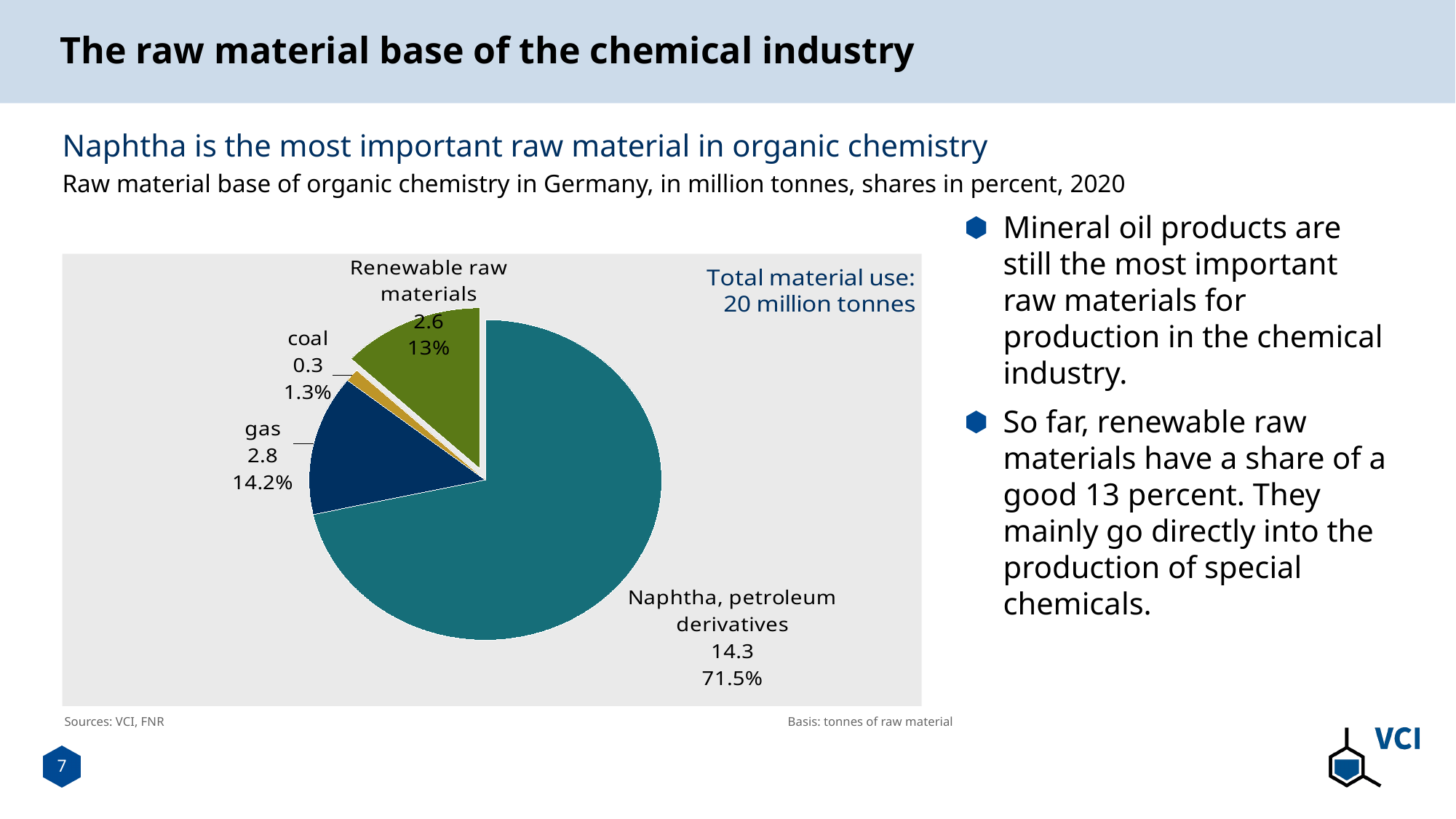
What is the share of Naphtha, petroleum derivatives? 71.5% What is the value in million tonnes for coal? 0.3 Which category has the largest slice? Naphtha, petroleum derivatives Which category has the smallest slice? coal What share of the pie does gas have? 14.2% What kind of chart is shown on the slide? pie chart What is the difference in million tonnes between gas and renewable raw materials? 0.2 What total material use is stated on the chart? 20 million tonnes What is the value in million tonnes for Naphtha, petroleum derivatives? 14.3 How many slices does the pie chart have? 4 Which is larger in million tonnes, gas or coal? gas What share of the pie do renewable raw materials have? 13%